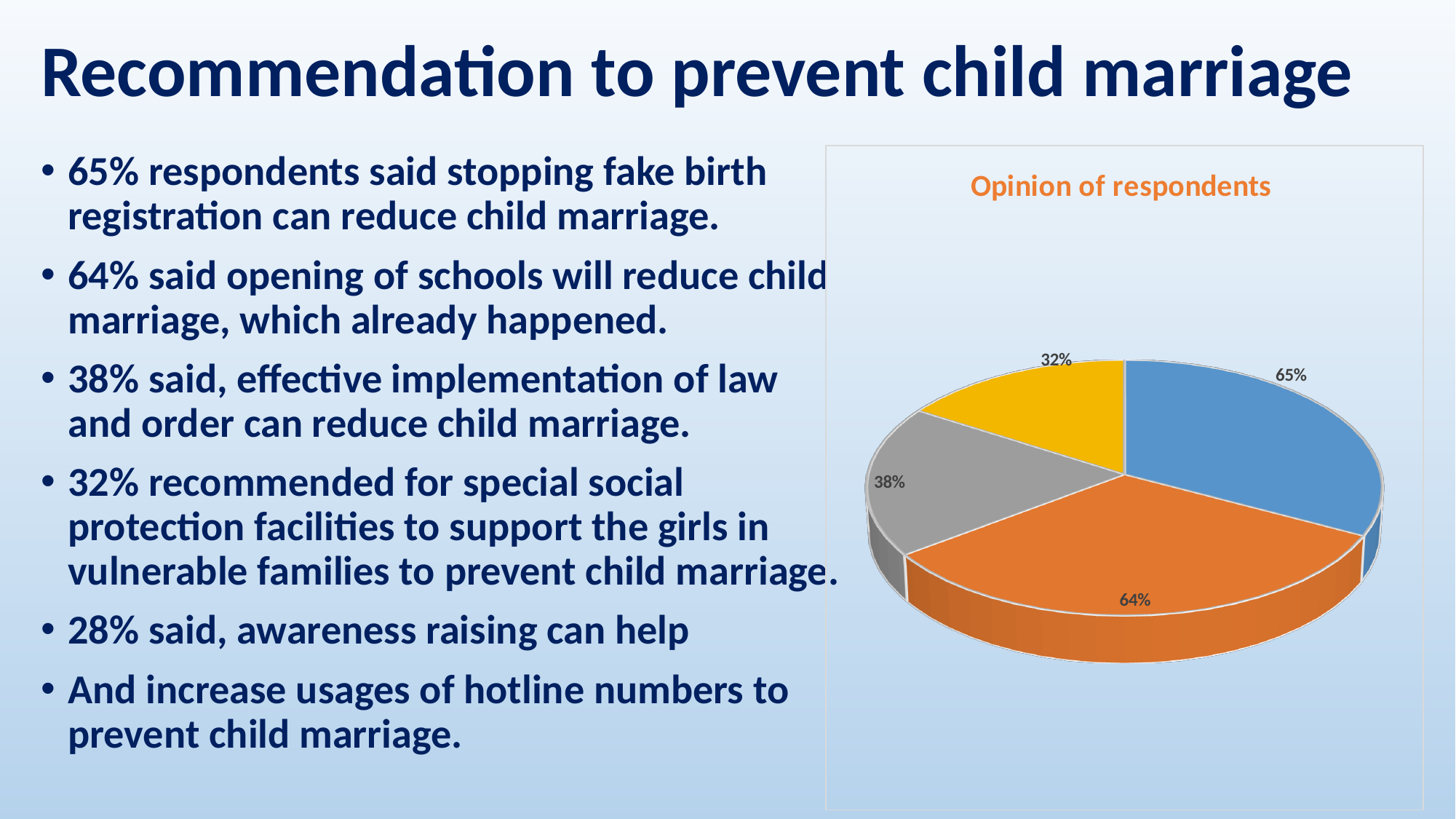
Which slice has the larger labelled value, the grey slice or the yellow slice? Grey slice What value is labelled on the yellow slice of the pie chart? 32% What is the difference between the largest labelled value (65%) and the smallest labelled value (32%) on the pie chart? 33 percentage points What is the largest value labelled on the pie chart? 65% What is the smallest value labelled on the pie chart? 32% What is the title of the chart on the slide? Opinion of respondents What value is labelled on the grey slice of the pie chart? 38% What colour is the slice with the largest labelled value on the pie chart? Blue What value is labelled on the blue slice of the pie chart? 65% What kind of chart is shown on the slide? Pie chart What value is labelled on the orange slice of the pie chart? 64% How many slices does the pie chart have? 4